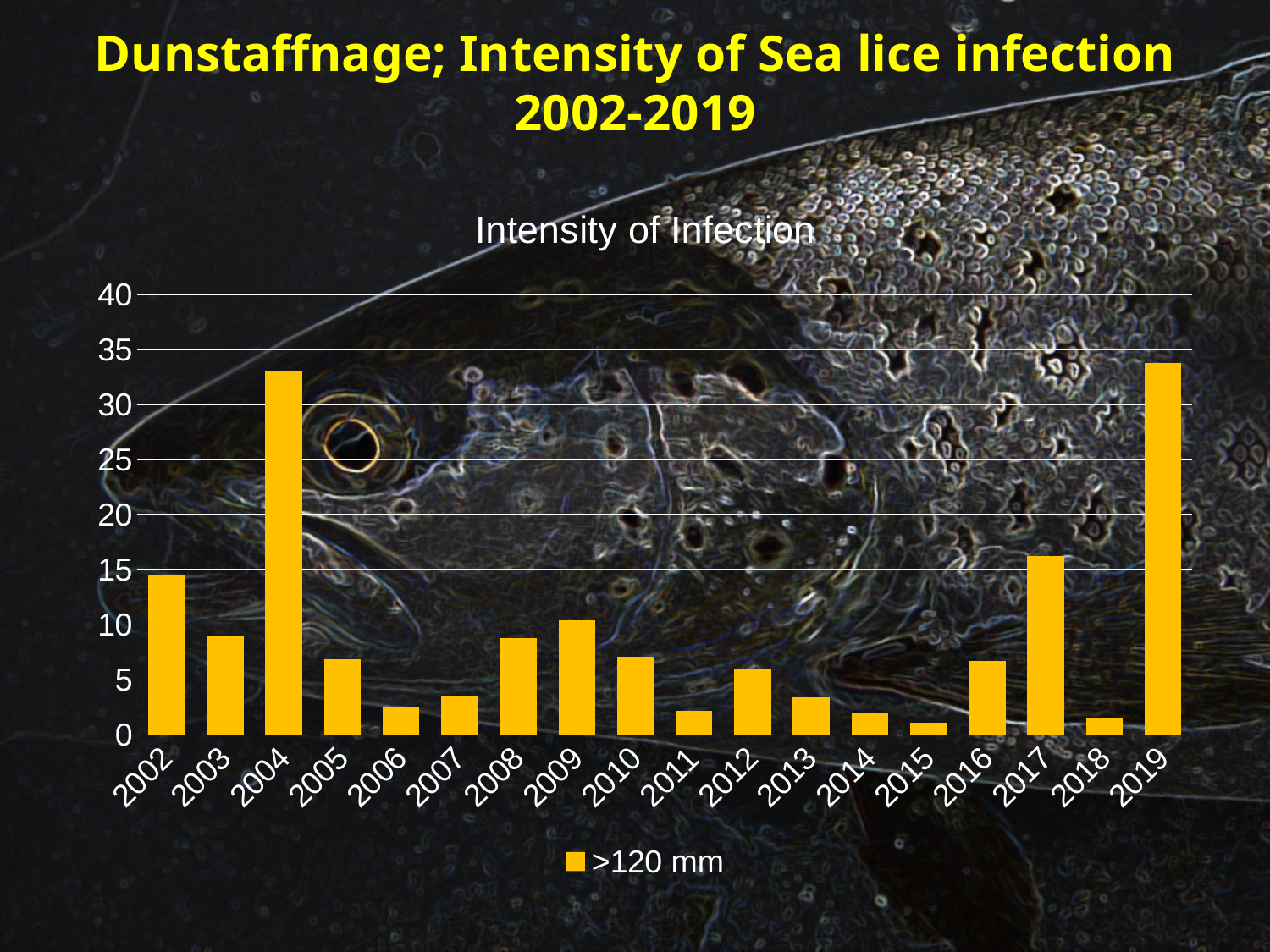
Is the value for 2015 greater or less than 5? less Which year has the larger value, 2017 or 2018? 2017 What is the legend entry for the series in the chart? >120 mm Is the value for 2002 greater or less than 10? greater Is the value for 2011 greater or less than 5? less How many series does the chart's legend list? 1 What is the title shown above the chart's plot area? Intensity of Infection What kind of chart is shown on the slide? bar chart How many years are plotted on the x axis of the chart? 18 Which year has the larger value, 2004 or 2002? 2004